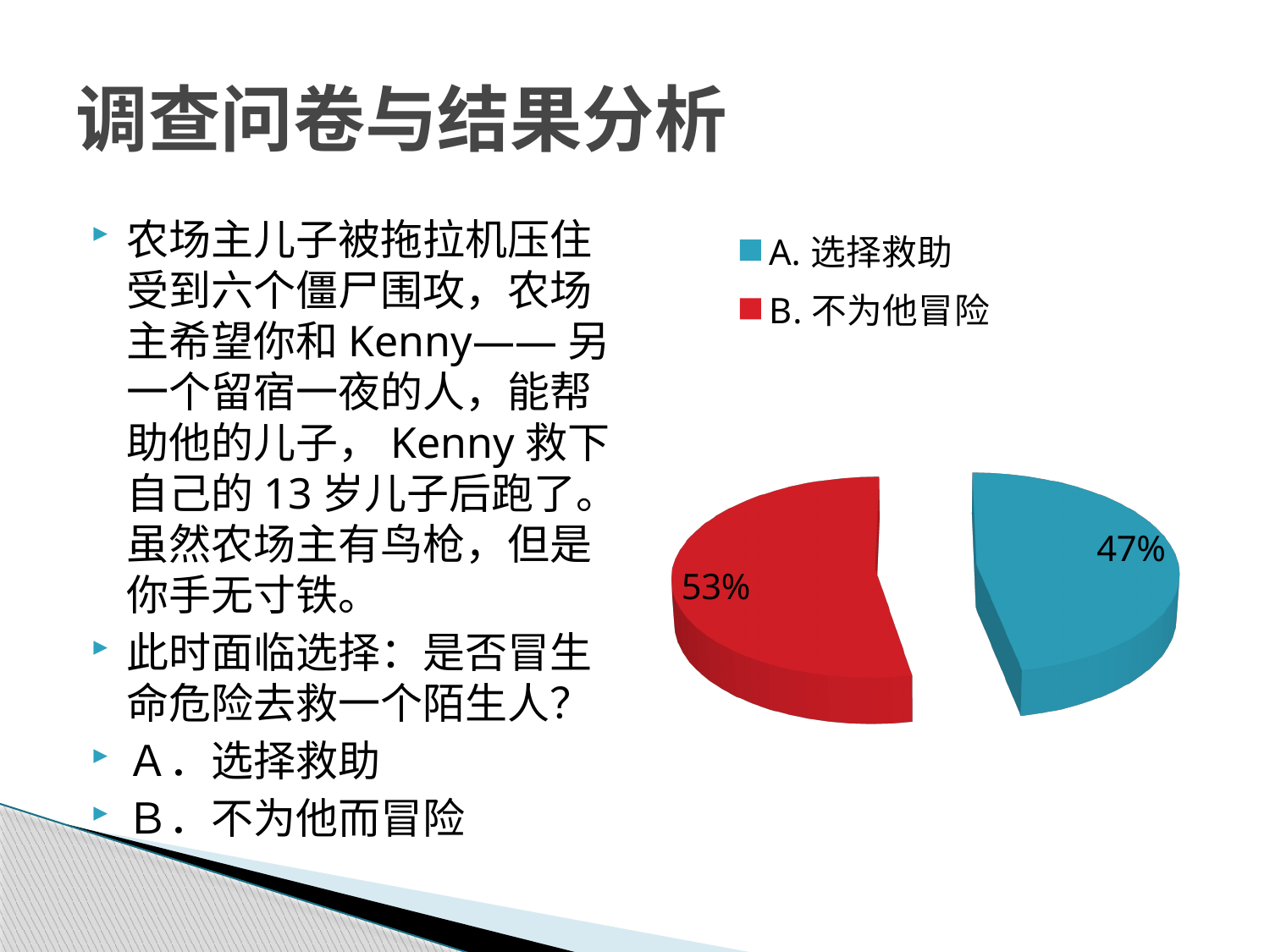
Is the share for "B. 不为他冒险" greater or less than 50%? greater What is the difference in percentage points between the "B. 不为他冒险" slice and the "A. 选择救助" slice? 6 Which slice of the pie is the largest? B. 不为他冒险 Which is larger, the share for "A. 选择救助" or the share for "B. 不为他冒险"? B. 不为他冒险 What colour is the slice for "B. 不为他冒险"? red How many entries does the legend list? 2 What percentage of the pie is labelled for "A. 选择救助"? 47% What kind of chart is shown on the slide? pie chart Which slice of the pie is the smallest? A. 选择救助 What percentage of the pie is labelled for "B. 不为他冒险"? 53% How many slices does the pie chart have? 2 What colour is the slice for "A. 选择救助"? blue